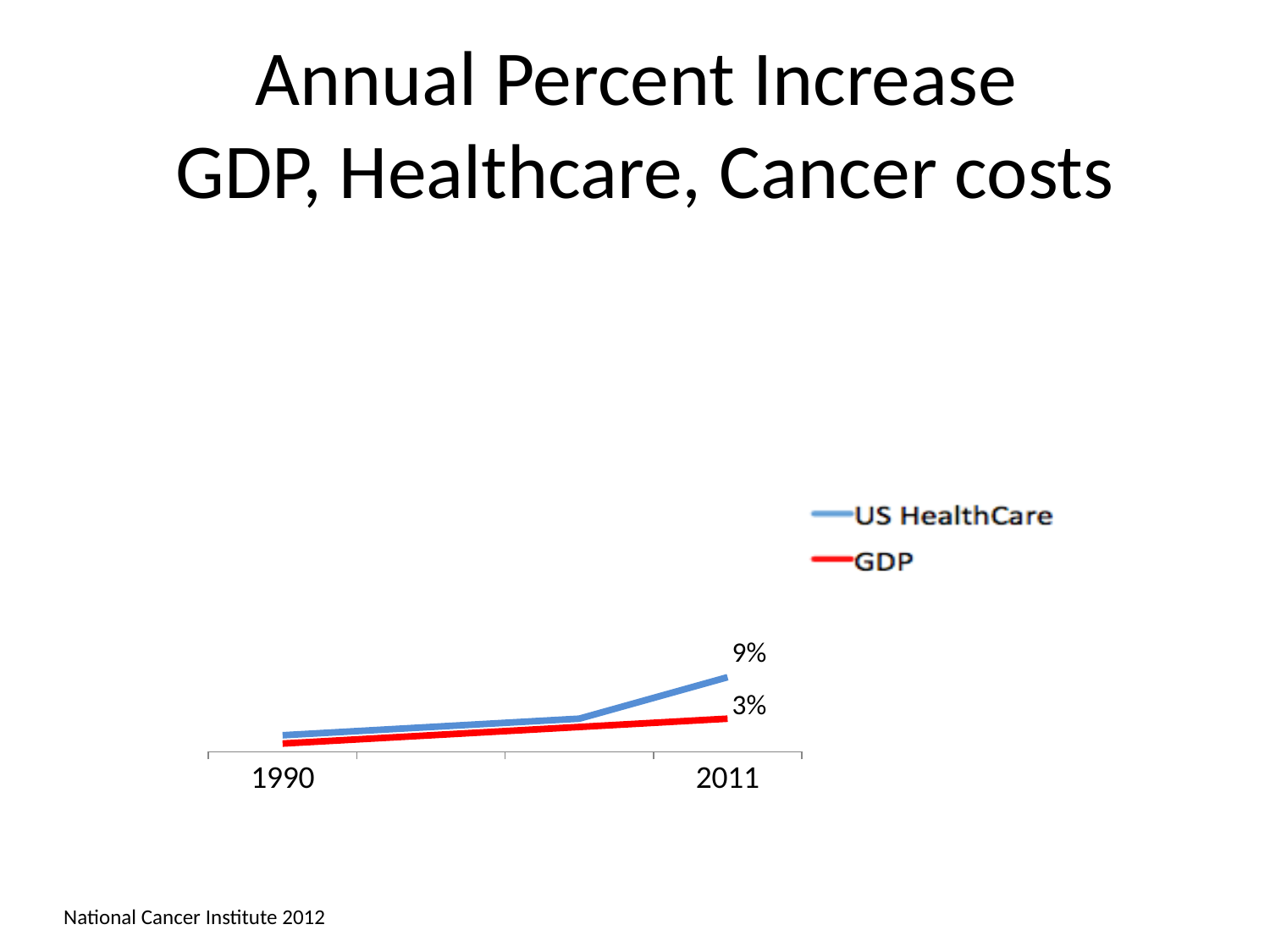
Does the GDP line rise or fall from 1990 to 2011? rise How many series does the legend list? 2 What is the value for US HealthCare in 2011? 9% Does the US HealthCare line rise or fall from 1990 to 2011? rise What are the two series named in the legend? US HealthCare and GDP Which series is drawn in red? GDP What is the difference between the US HealthCare and GDP values in 2011? 6% What is the value for GDP in 2011? 3% Which series has the higher value in 2011, US HealthCare or GDP? US HealthCare What kind of chart is shown on the slide? line chart